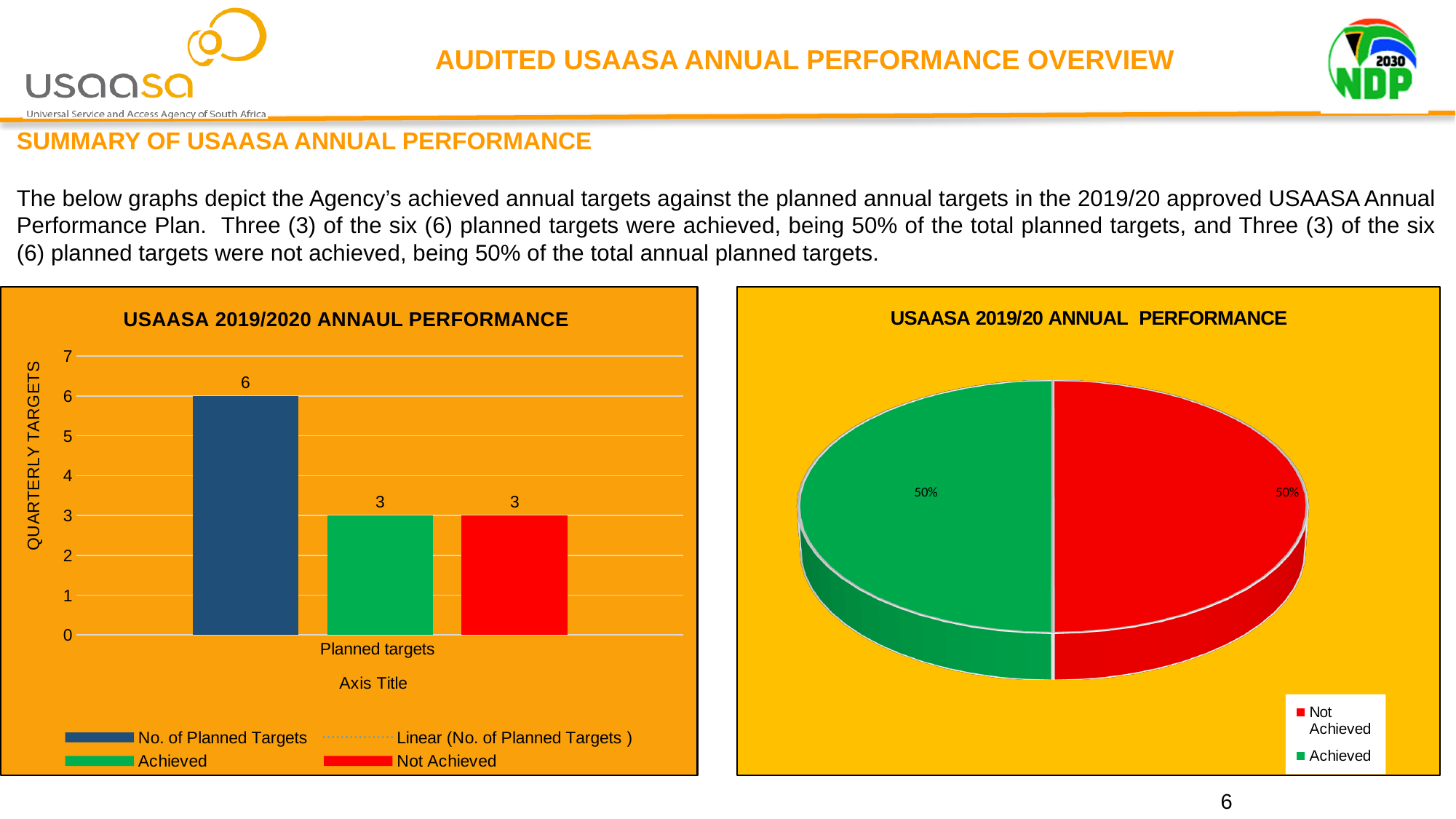
In the bar chart on the left, which series has the highest value? No. of Planned Targets What kind of chart is the chart on the left of the slide? Bar chart In the pie chart on the right, what colour is the Not Achieved slice? Red In the bar chart on the left, what is the value for Achieved? 3 In the bar chart on the left, what is the y-axis title? QUARTERLY TARGETS In the bar chart on the left, what is the difference between No. of Planned Targets and Achieved? 3 In the pie chart on the right, what share does Achieved have? 50% In the bar chart on the left, which is larger: No. of Planned Targets or Not Achieved? No. of Planned Targets In the bar chart on the left, how many entries does the legend list? 4 In the bar chart on the left, what is the value for Not Achieved? 3 In the pie chart on the right, how many slices are there? 2 In the bar chart on the left, what is the value for No. of Planned Targets? 6